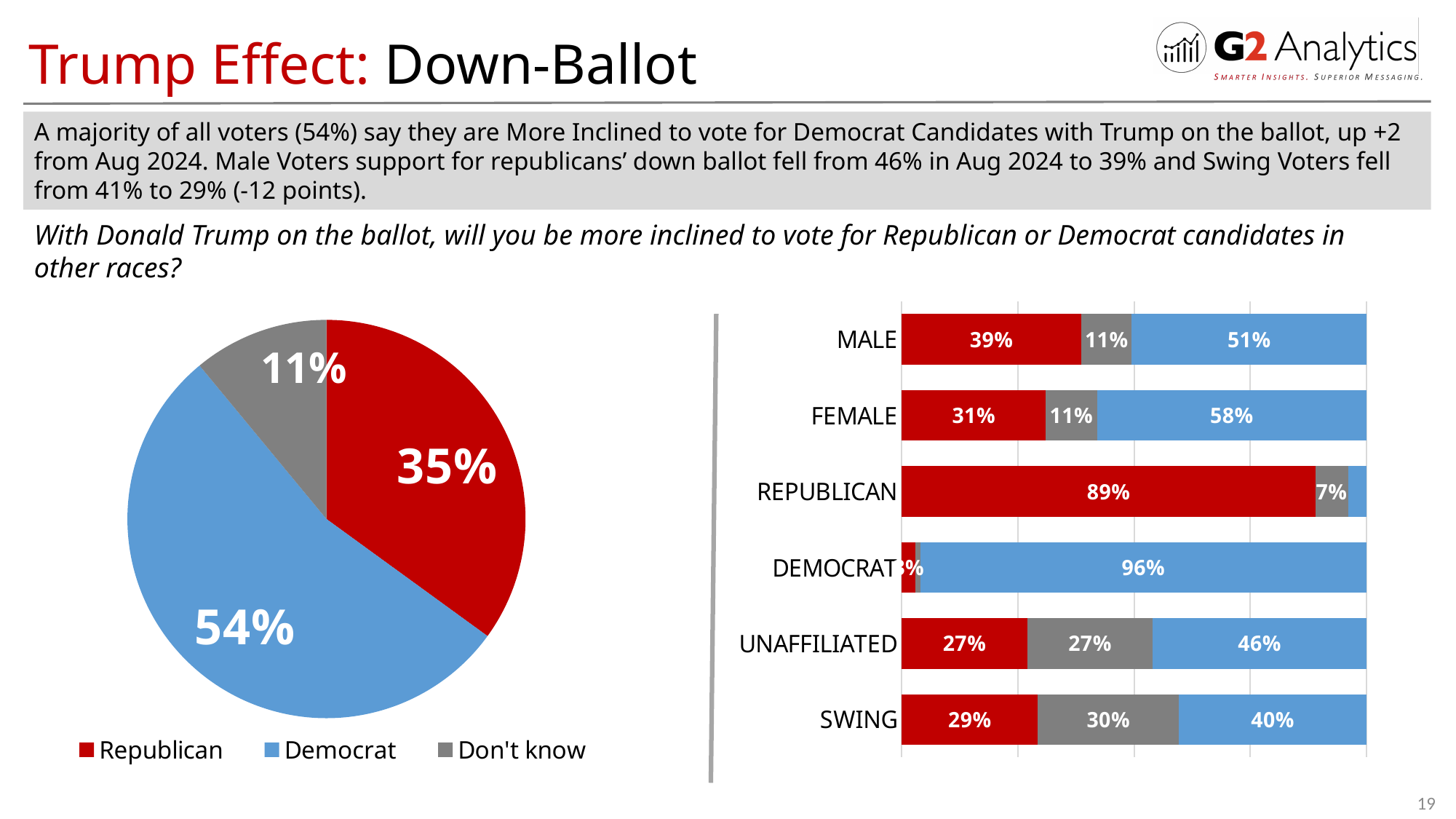
In the bar chart on the right, what is the difference between the Democrat value for FEMALE voters and the Democrat value for MALE voters? 7 percentage points In the bar chart on the right, which is larger: the Republican value for UNAFFILIATED voters or the Republican value for SWING voters? SWING In the pie chart on the left, which response has the smallest slice? Don't know In the pie chart on the left, what share of voters say they are more inclined to vote for Democrat candidates? 54% What kind of chart is the chart on the left side of the slide? Pie chart What kind of chart is the chart on the right side of the slide? Stacked bar chart In the bar chart on the right, what is the Democrat value for FEMALE voters? 58% In the pie chart on the left, which response has the largest slice? Democrat In the bar chart on the right, what is the Don't know value for SWING voters? 30% In the bar chart on the right, what is the Republican value for MALE voters? 39% How many entries does the legend of the pie chart on the left list? 3 How many voter groups are shown in the bar chart on the right? 6